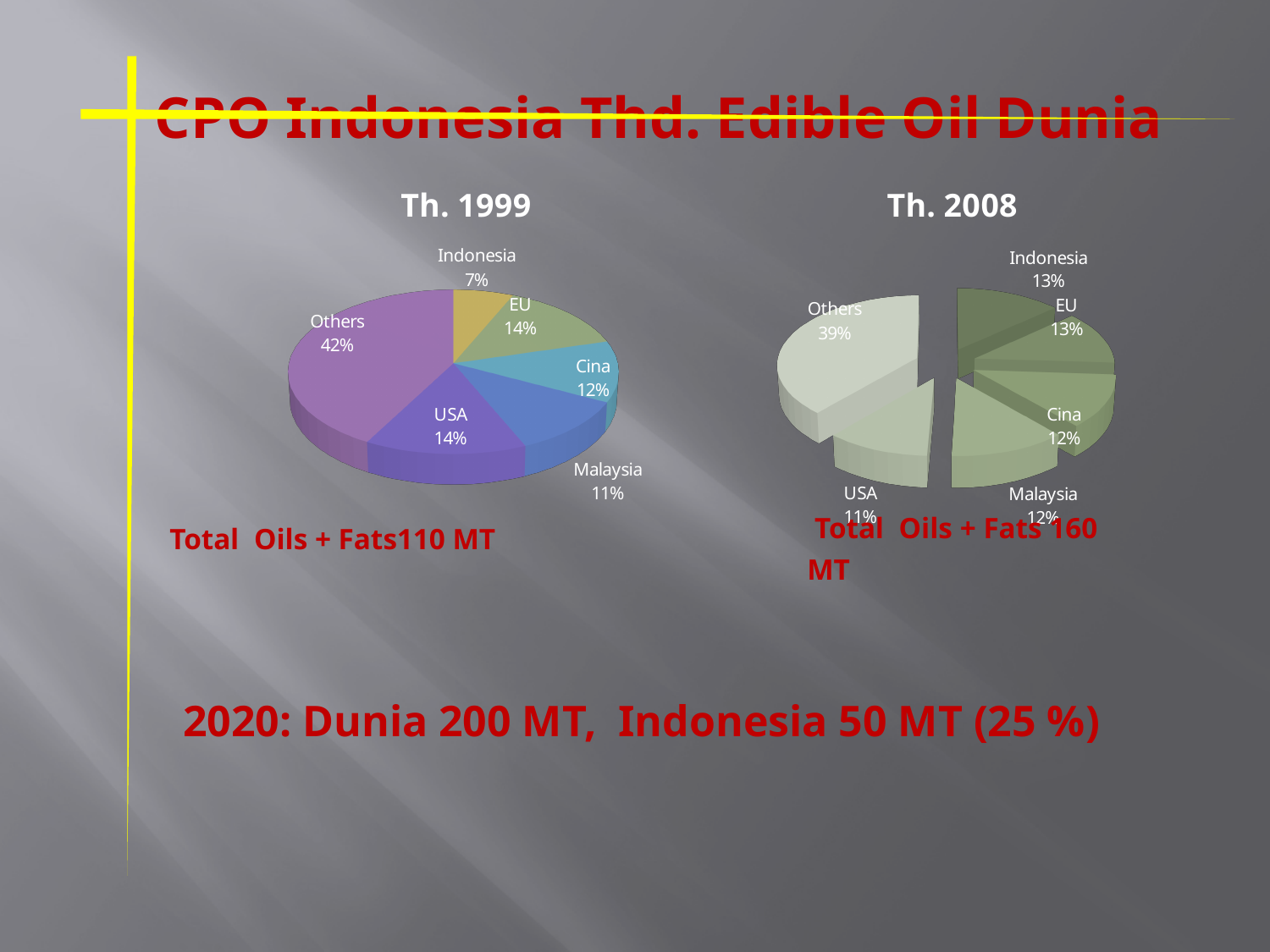
In the Th. 1999 pie chart, which category has the largest slice? Others In the Th. 1999 pie chart, which category has the smallest slice? Indonesia By how many percentage points did Indonesia's share increase from the Th. 1999 chart to the Th. 2008 chart? 6 percentage points In the Th. 1999 pie chart, what share does USA have? 14% In the Th. 1999 pie chart, what share does Others have? 42% In the Th. 2008 pie chart, what share does Others have? 39% What kind of chart is the Th. 2008 chart? Pie chart In the Th. 2008 pie chart, what share does Indonesia have? 13% In the Th. 1999 pie chart, which is larger, the EU slice or the Cina slice? EU How many slices does the Th. 1999 pie chart have? 6 In the Th. 1999 pie chart, what is the difference between the Others share and the USA share? 28 percentage points In the Th. 1999 pie chart, what share does Indonesia have? 7%